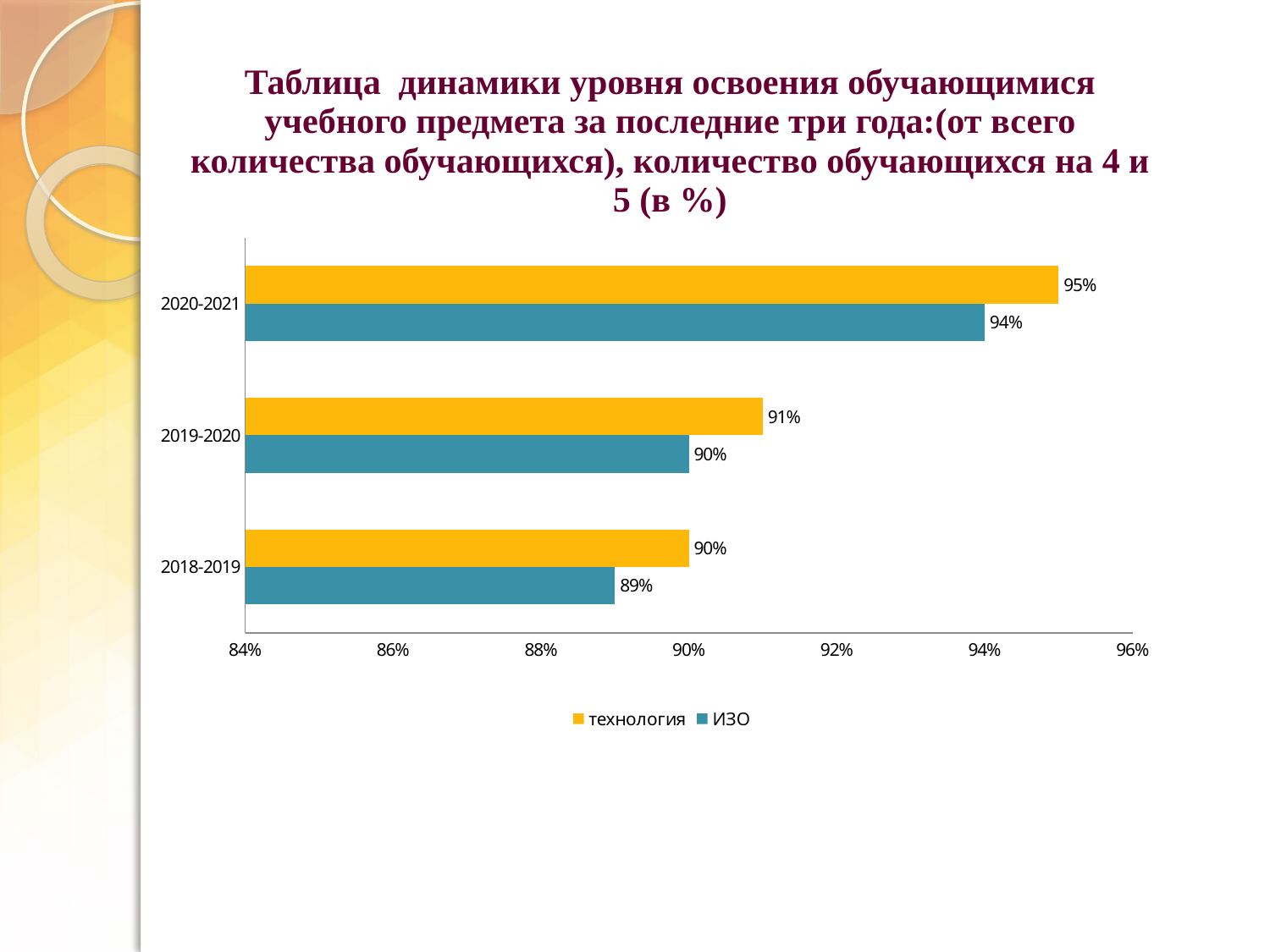
What is the value for ИЗО in 2019-2020? 90% How many year categories are shown on the chart? 3 What is the value for технология in 2020-2021? 95% What kind of chart is shown on the slide? bar chart Is the value for ИЗО in 2020-2021 greater or less than 92%? greater Which year has the lowest value for ИЗО? 2018-2019 How many series does the legend list? 2 Which is larger in 2020-2021, технология or ИЗО? технология What is the value for ИЗО in 2018-2019? 89% Which year has the highest value for технология? 2020-2021 What is the difference between the технология values for 2020-2021 and 2018-2019? 5% What is the difference between технология and ИЗО in 2019-2020? 1%